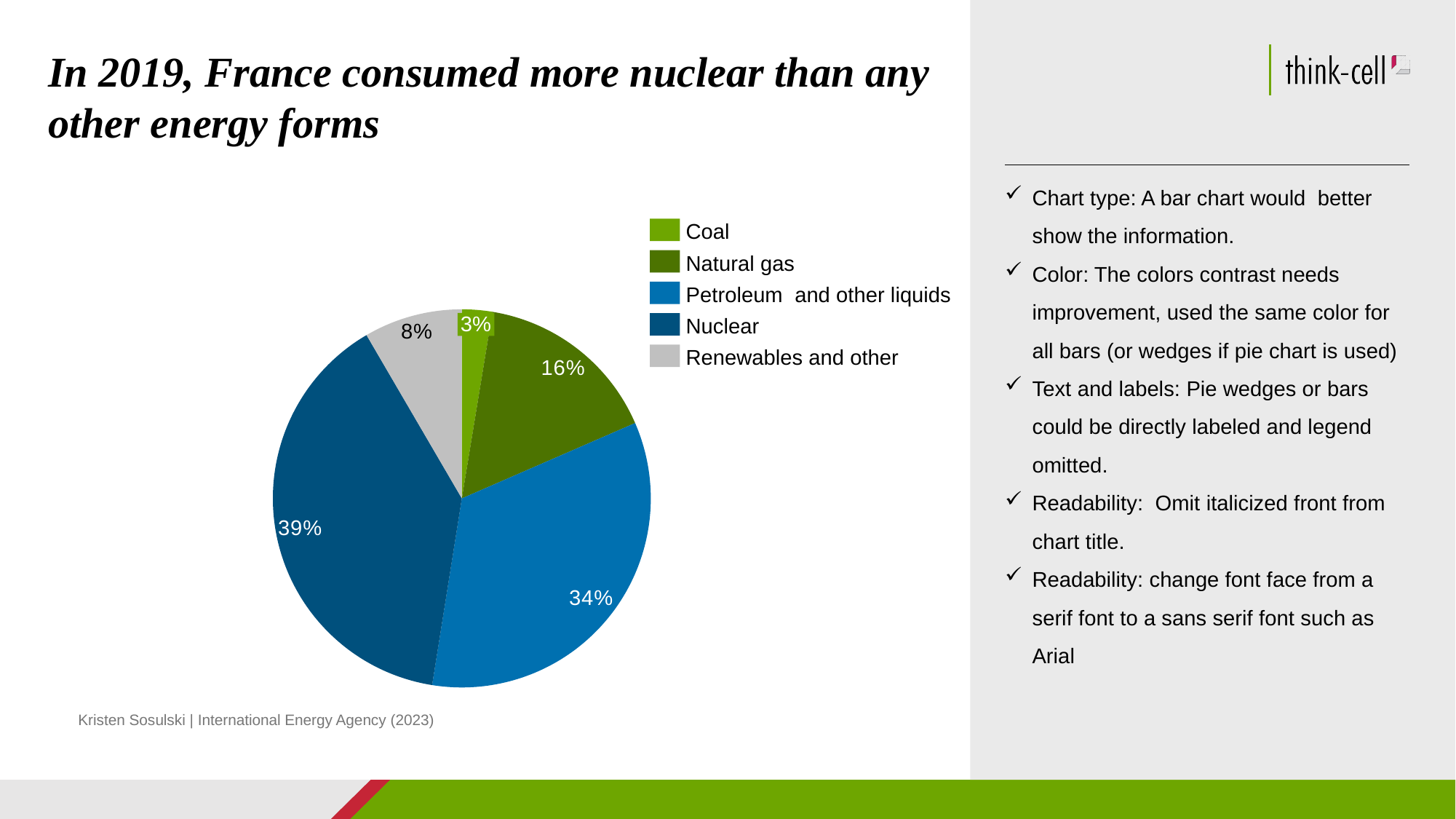
What is the value for Renewables and other? 8% Which energy form has the smallest slice of the pie? Coal Which energy form has the largest slice of the pie? Nuclear What kind of chart is shown on the slide? Pie chart What is the value for Natural gas? 16% What is the value for Petroleum and other liquids? 34% What is the difference in percentage points between Nuclear and Petroleum and other liquids? 5 percentage points What share of the pie does Nuclear account for? 39% How many categories does the pie chart show? 5 Which is larger, the share for Natural gas or the share for Renewables and other? Natural gas Which legend entry is shown in light grey? Renewables and other What is the value for Coal? 3%